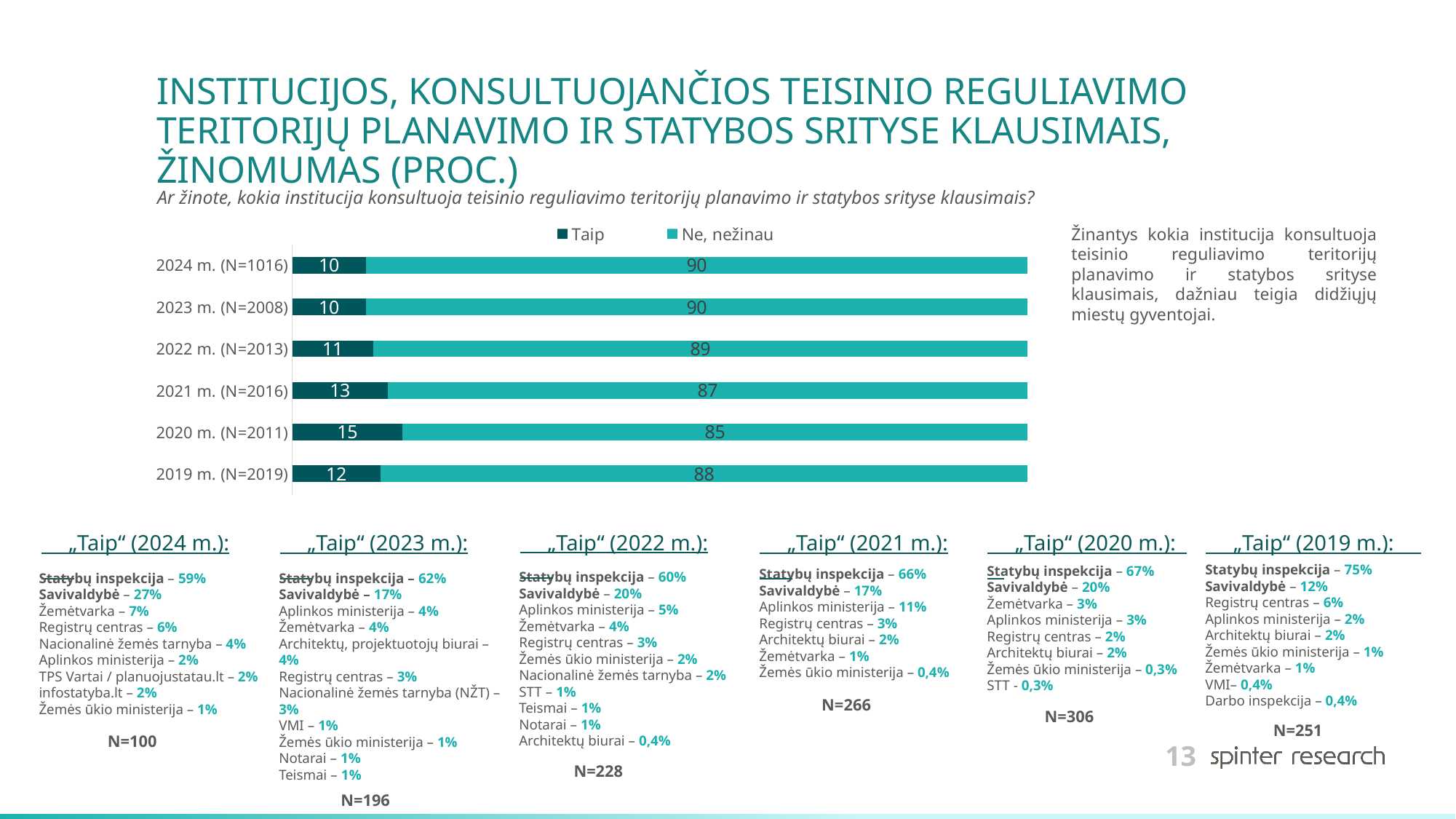
What is the "Taip" value for 2024 m. (N=1016)? 10 What type of chart is shown on the slide? bar chart Which is larger, the "Taip" value for 2019 m. or for 2022 m.? 2019 m. What is the total of the stacked bar for 2022 m. (N=2013)? 100 How many series does the chart legend list? 2 Which year has the lowest "Ne, nežinau" value? 2020 m. (N=2011) What is the "Ne, nežinau" value for 2020 m. (N=2011)? 85 Which series is shown in the darker colour in the chart? Taip What is the difference between the "Taip" values for 2020 m. and 2024 m.? 5 Which year has the highest "Taip" value? 2020 m. (N=2011) How many year categories are plotted in the chart? 6 What is the "Taip" value for 2021 m. (N=2016)? 13